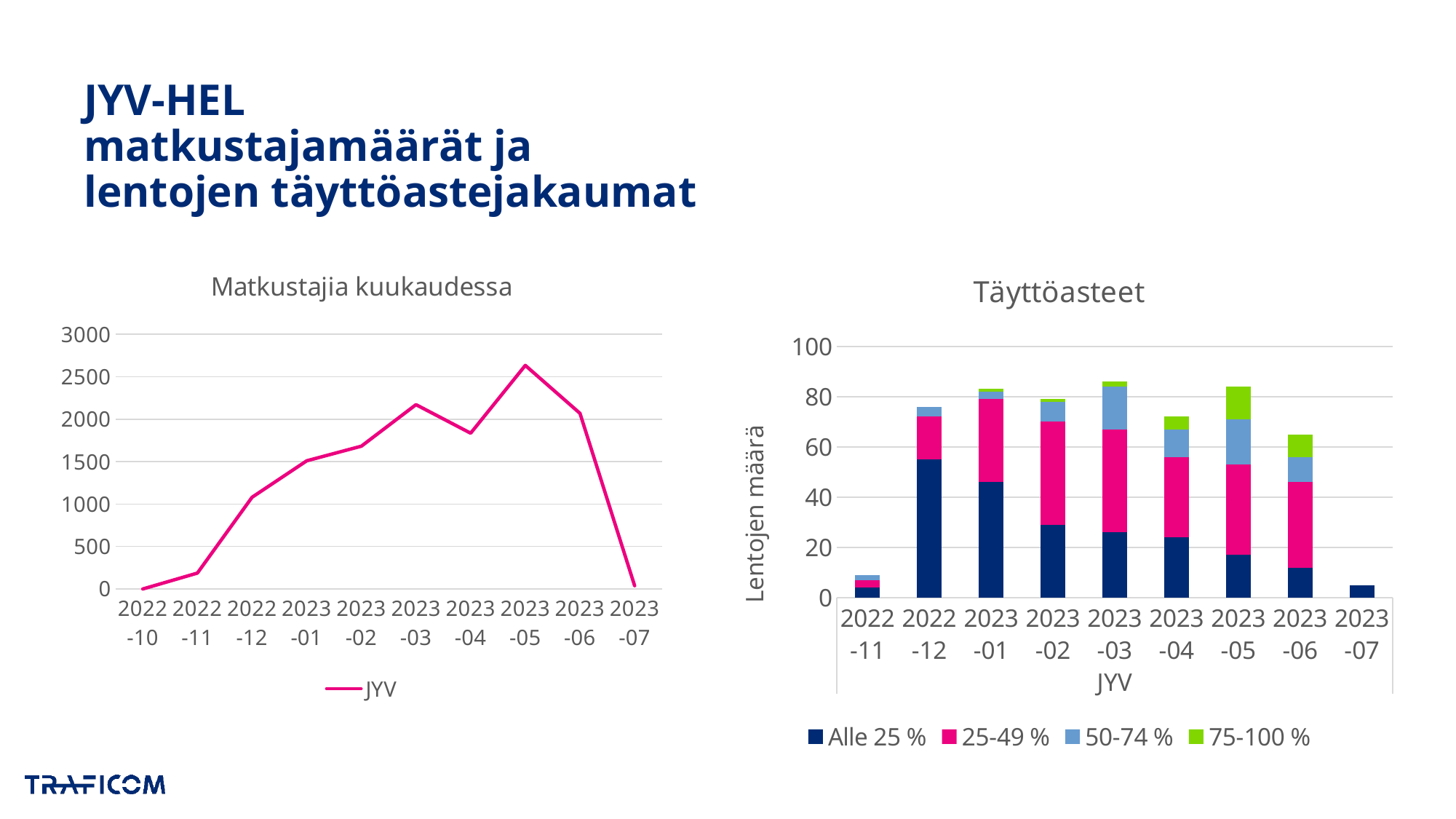
In the 'Matkustajia kuukaudessa' chart, which month has the highest number of passengers? 2023-05 How many series does the legend of the 'Täyttöasteet' chart list? 4 What type of chart is the 'Täyttöasteet' chart? Bar chart What type of chart is the 'Matkustajia kuukaudessa' chart? Line chart In the 'Täyttöasteet' chart, is the total for 2022-12 greater or less than 60? greater In the 'Matkustajia kuukaudessa' chart, how does the passenger count change from 2023-05 to 2023-07? It falls In the 'Täyttöasteet' chart, which month has the largest 'Alle 25 %' segment? 2022-12 In the 'Matkustajia kuukaudessa' chart, how many months are plotted on the x axis? 10 In the 'Täyttöasteet' chart, which month has the lowest total number of flights? 2023-07 In the 'Matkustajia kuukaudessa' chart, is the value for 2022-11 greater or less than 500? less In the 'Matkustajia kuukaudessa' chart, is the value for 2023-04 greater or less than 1500? greater